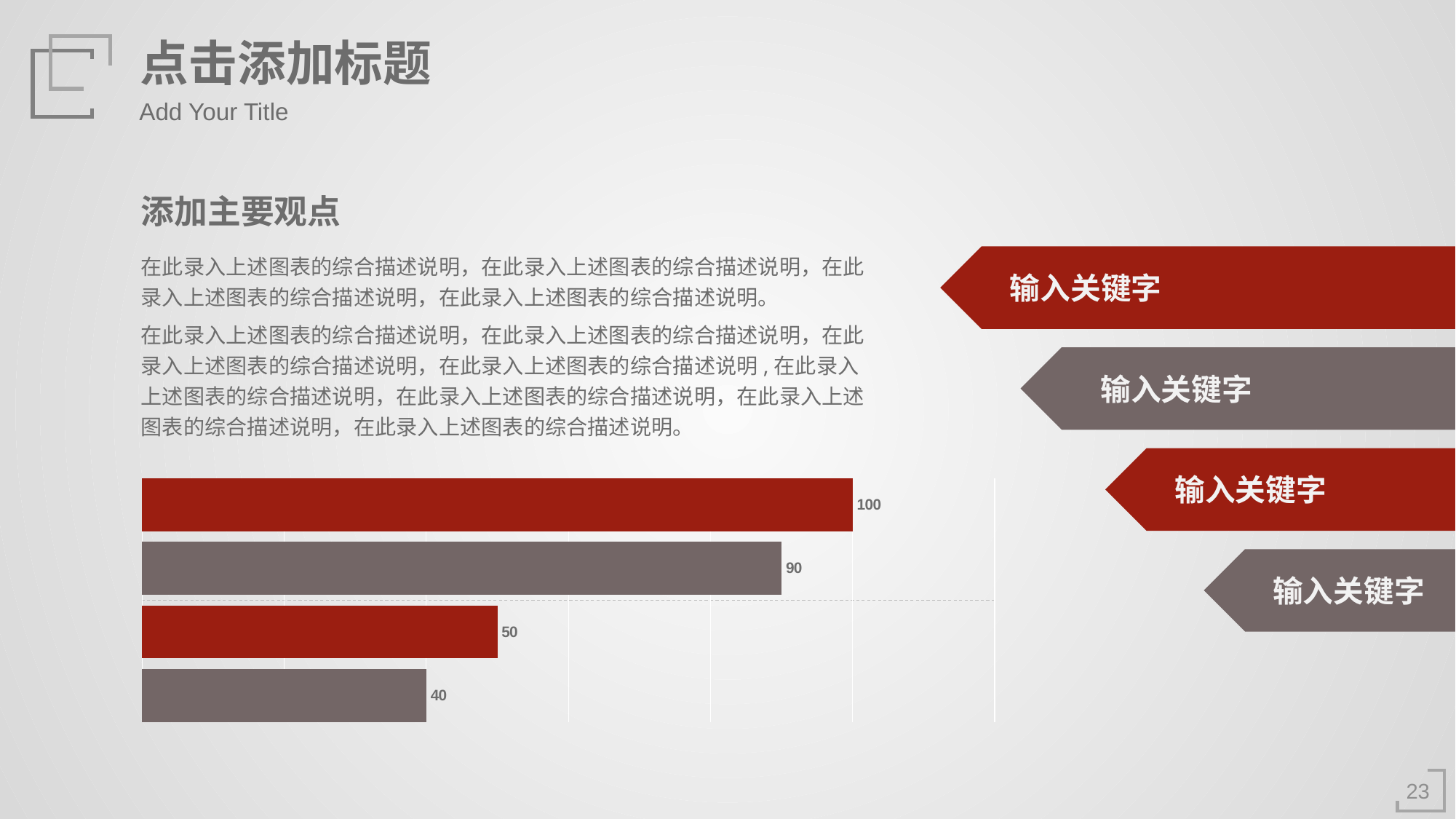
What kind of chart is shown on the slide? bar chart How many bars does the chart show? 4 What is the lowest value shown in the chart? 40 What is the value of the top bar in the chart? 100 What is the value of the bottom bar in the chart? 40 What is the difference between the second bar and the third bar from the top in the chart? 40 What is the value of the third bar from the top in the chart? 50 Which is larger, the top bar or the second bar from the top? the top bar What is the difference between the top bar and the bottom bar in the chart? 60 What colour is the top bar in the chart? red What is the highest value shown in the chart? 100 What is the value of the second bar from the top in the chart? 90